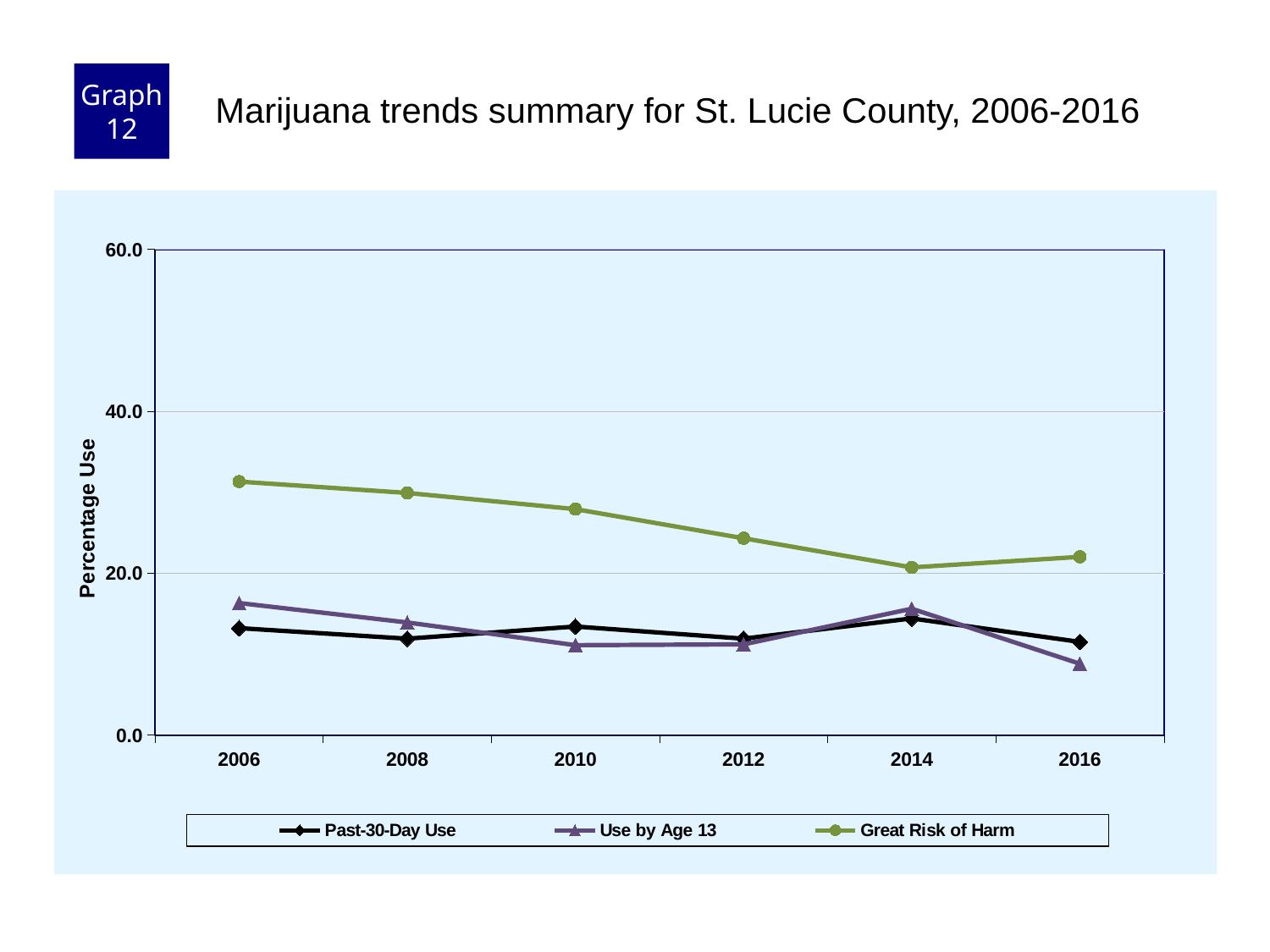
Is the value for Great Risk of Harm in 2006 greater or less than 20.0? greater Does the Great Risk of Harm series rise or fall from 2006 to 2014? Fall Which year has the lowest value for Use by Age 13? 2016 How many years are plotted along the x axis? 6 Is the value for Past-30-Day Use in 2016 greater or less than 20.0? less In 2016, which is larger: Past-30-Day Use or Use by Age 13? Past-30-Day Use Is the value for Great Risk of Harm in 2006 greater or less than 40.0? less What kind of chart is shown on the slide? Line chart Which year has the highest value for Great Risk of Harm? 2006 How many series does the legend list? 3 Which year has the lowest value for Great Risk of Harm? 2014 What is the label on the y axis? Percentage Use